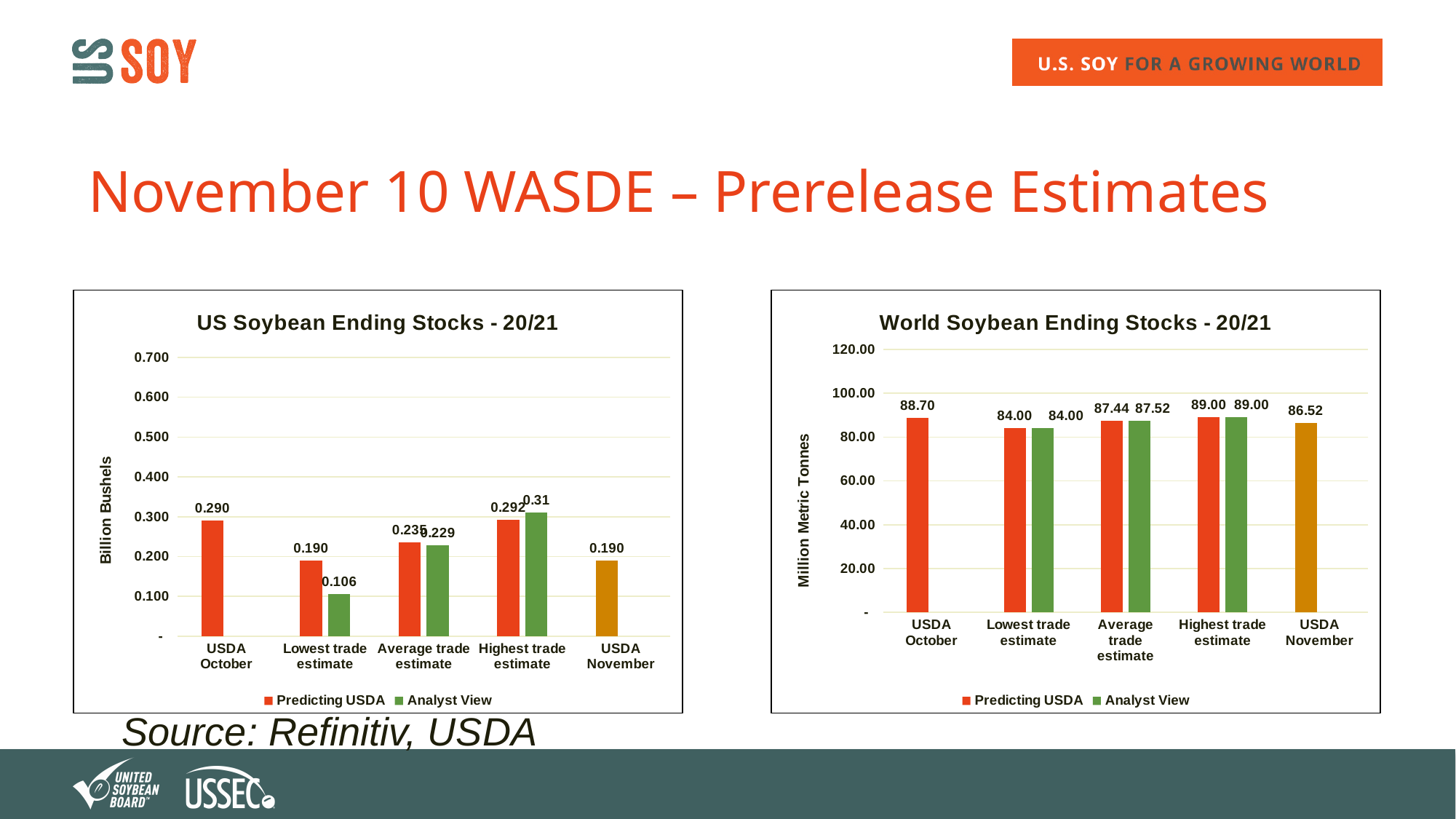
In the US Soybean Ending Stocks - 20/21 chart, what is the value shown for USDA November? 0.190 In the US Soybean Ending Stocks - 20/21 chart, what is the Analyst View value for the Lowest trade estimate? 0.106 In the World Soybean Ending Stocks - 20/21 chart, what is the difference between the USDA October value and the USDA November value? 2.18 In the World Soybean Ending Stocks - 20/21 chart, what is the Analyst View value for the Average trade estimate? 87.52 In the US Soybean Ending Stocks - 20/21 chart, what is the difference between the Predicting USDA and Analyst View values for the Highest trade estimate? 0.018 In the US Soybean Ending Stocks - 20/21 chart, what is the Predicting USDA value for USDA October? 0.290 In the US Soybean Ending Stocks - 20/21 chart, how many series does the legend list? 2 In the World Soybean Ending Stocks - 20/21 chart, what is the Predicting USDA value for USDA October? 88.70 In the World Soybean Ending Stocks - 20/21 chart, is the Predicting USDA value for the Lowest trade estimate greater or less than 80.00? greater What kind of chart is the World Soybean Ending Stocks - 20/21 chart? Bar chart In the World Soybean Ending Stocks - 20/21 chart, how many categories are shown on the x axis? 5 In the US Soybean Ending Stocks - 20/21 chart, which category has the lowest Analyst View value? Lowest trade estimate